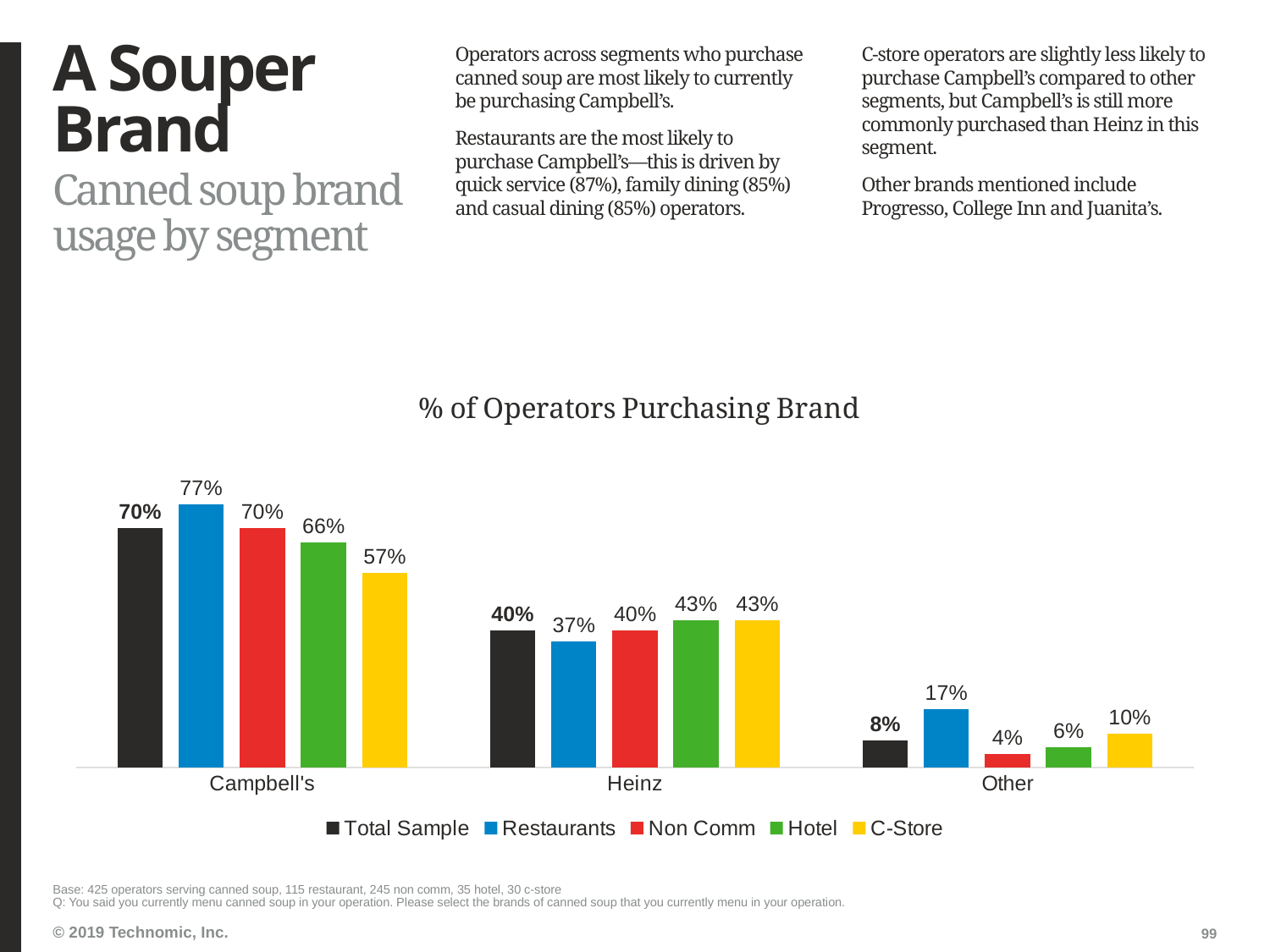
What kind of chart is shown on the slide? Bar chart How many series does the legend list? 5 What percentage of Restaurants operators purchase Campbell's? 77% What percentage of C-Store operators purchase Heinz? 43% How many brand categories are shown on the x axis? 3 What is the difference between the Restaurants and C-Store values for Campbell's? 20% Which segment has the lowest percentage purchasing Other brands? Non Comm What is the Total Sample value for Other brands? 8% Which colour represents the Hotel series in the legend? Green Which is larger for Heinz: the Hotel value or the Restaurants value? Hotel What is the title of the chart? % of Operators Purchasing Brand Which segment has the highest percentage purchasing Campbell's? Restaurants